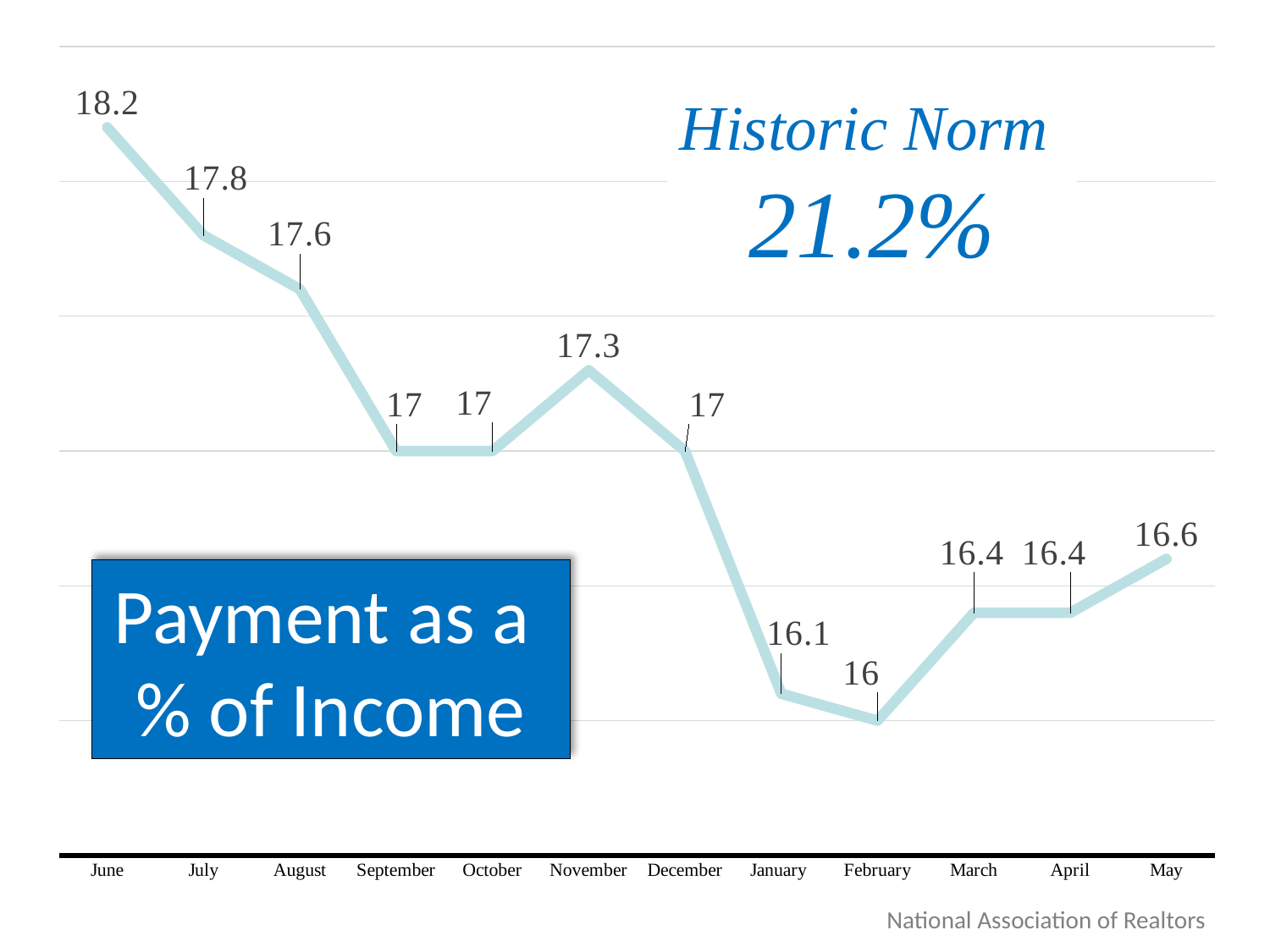
What kind of chart is shown on the slide? Line chart What historic norm value is shown on the slide? 21.2% Which month has the lowest value? February What is the value for May? 16.6 What is the difference between the values for December and January? 0.9 What is the value for February? 16 How many months are plotted on the chart? 12 What is the difference between the values for June and February? 2.2 What is the value for November? 17.3 Which month has the highest value? June What is the value for June? 18.2 Which is larger, the value for November or the value for March? November